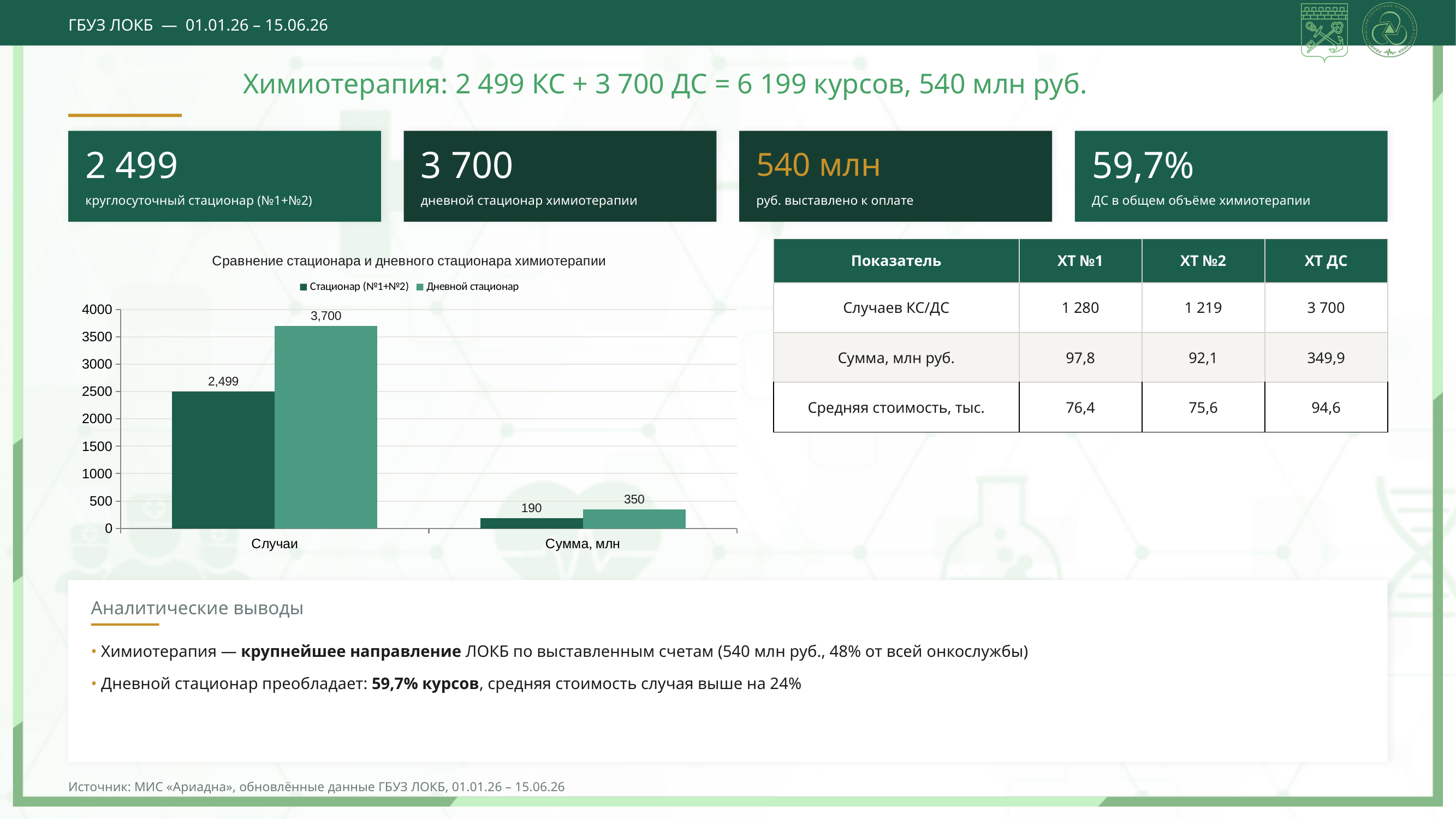
Which series has the larger value in the Случаи category? Дневной стационар How many series does the chart legend list? 2 What is the difference between Дневной стационар and Стационар (№1+№2) in the Сумма, млн category? 160 What is the value for Стационар (№1+№2) in the Сумма, млн category? 190 What is the title of the chart? Сравнение стационара и дневного стационара химиотерапии What type of chart is shown on the slide? bar chart What is the difference between Дневной стационар and Стационар (№1+№2) in the Случаи category? 1,201 How many categories are shown on the x axis of the chart? 2 What is the value for Стационар (№1+№2) in the Случаи category? 2,499 What is the value for Дневной стационар in the Сумма, млн category? 350 Is the value for Стационар (№1+№2) in the Случаи category greater or less than 2000? greater What is the value for Дневной стационар in the Случаи category? 3,700